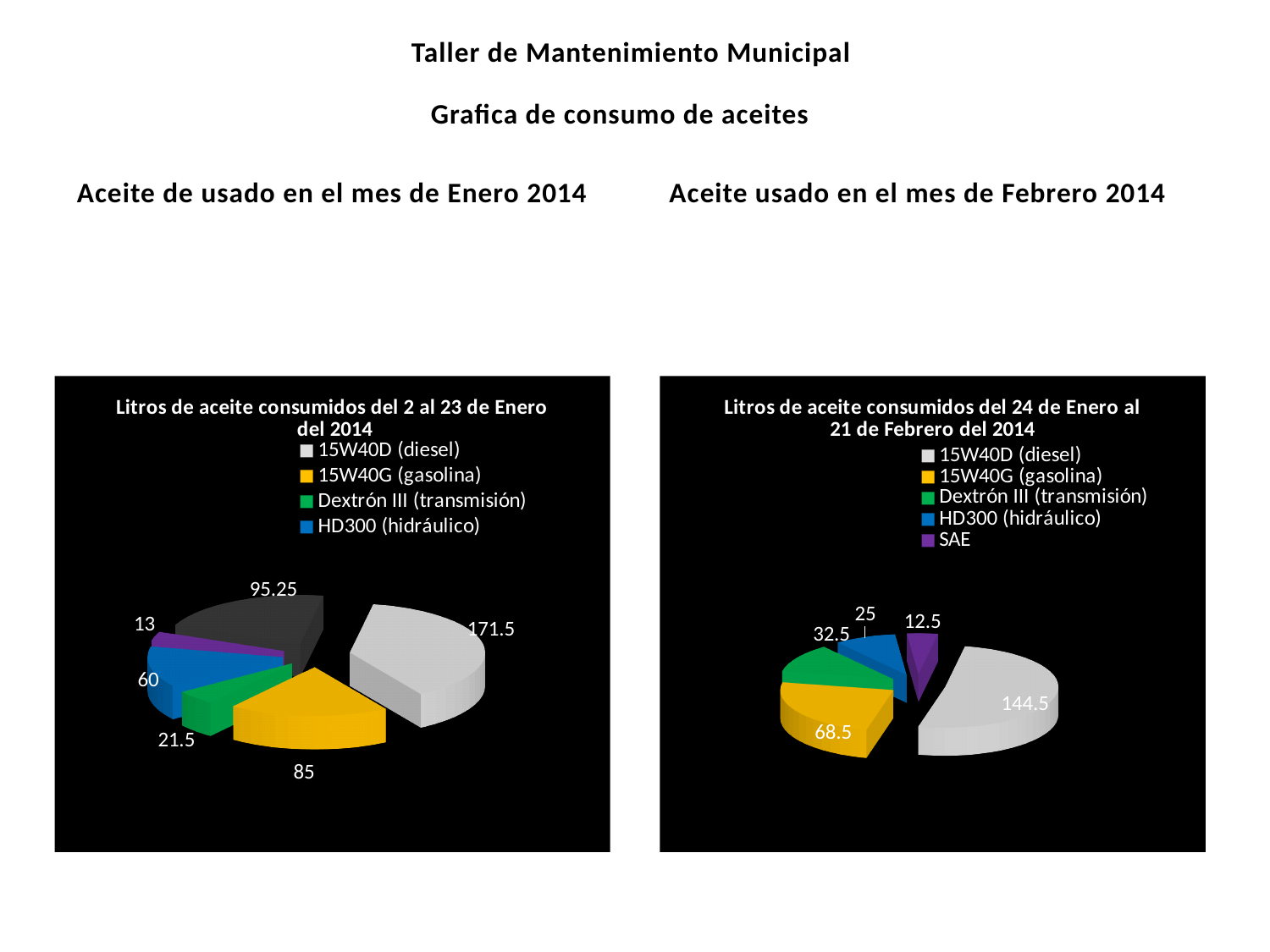
In the left chart (2 al 23 de Enero), what is the value for 15W40G (gasolina)? 85 In the left chart (2 al 23 de Enero), what is the value for HD300 (hidráulico)? 60 How many slices does the left chart (2 al 23 de Enero) have? 6 What type of chart is used on the left chart, 'Litros de aceite consumidos del 2 al 23 de Enero del 2014'? Pie chart In the right chart (24 de Enero al 21 de Febrero), what is the value for 15W40D (diesel)? 144.5 In the left chart (2 al 23 de Enero), which category has the largest slice? 15W40D (diesel) In the right chart (24 de Enero al 21 de Febrero), which category has the smallest slice? SAE In the left chart (2 al 23 de Enero), what is the value for 15W40D (diesel)? 171.5 In the right chart (24 de Enero al 21 de Febrero), which is larger: 15W40G (gasolina) or Dextrón III (transmisión)? 15W40G (gasolina) In the right chart (24 de Enero al 21 de Febrero), what is the value for SAE? 12.5 In the left chart (2 al 23 de Enero), what is the difference between the 15W40D (diesel) value and the 15W40G (gasolina) value? 86.5 How many entries does the legend of the right chart (24 de Enero al 21 de Febrero) list? 5